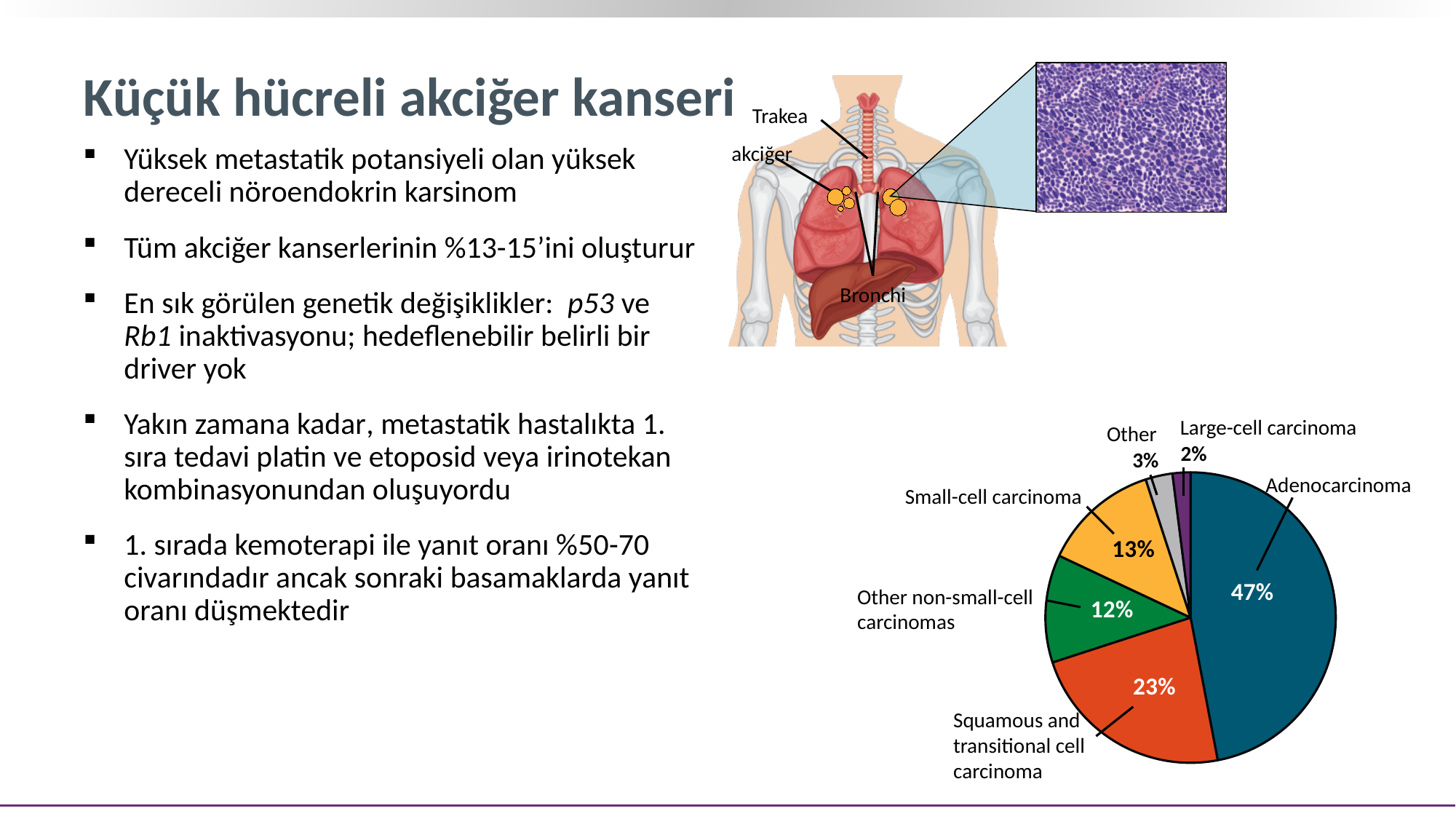
What is the difference in percentage points between Adenocarcinoma and Squamous and transitional cell carcinoma? 24 What percentage is shown for Small-cell carcinoma in the pie chart? 13% What share of the pie chart does Adenocarcinoma represent? 47% Which slice of the pie chart is the smallest? Large-cell carcinoma What kind of chart is shown on the slide? pie chart What percentage is shown for Large-cell carcinoma? 2% Which is larger in the pie chart, Small-cell carcinoma or Other non-small-cell carcinomas? Small-cell carcinoma How many slices does the pie chart have? 6 What colour is the Adenocarcinoma slice in the pie chart? dark teal blue Which slice of the pie chart is the largest? Adenocarcinoma What percentage is shown for Other non-small-cell carcinomas? 12% What percentage is shown for Squamous and transitional cell carcinoma? 23%